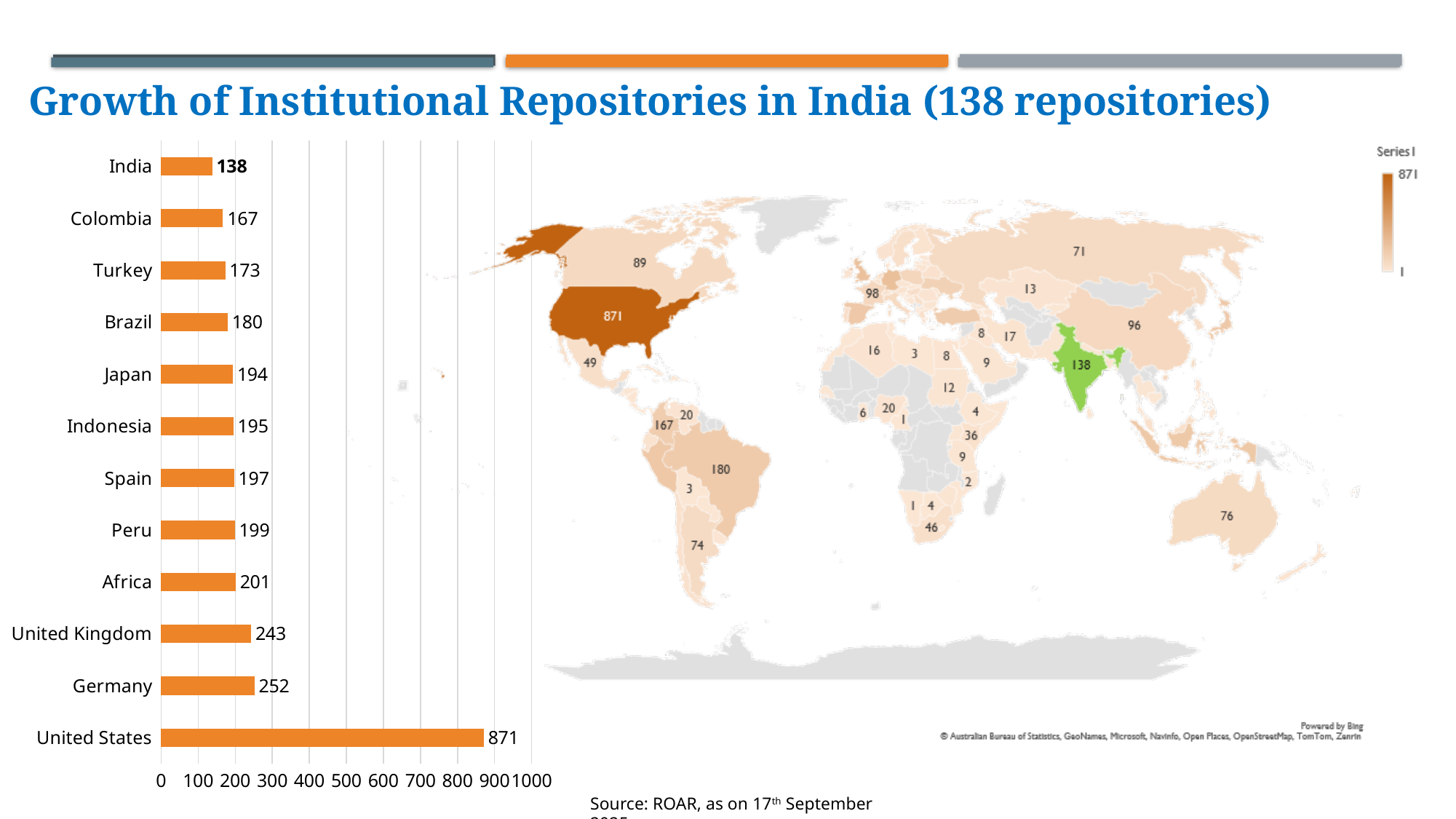
What kind of chart is shown on the left of the slide? Bar chart On the map chart on the right, what value is labelled on Australia? 76 On the bar chart on the left, which is larger, the value for United Kingdom or the value for Africa? United Kingdom On the map chart on the right, what value is labelled on the United States? 871 On the bar chart on the left, what is the difference between the values for United States and Germany? 619 On the bar chart on the left, how many categories are shown? 12 On the bar chart on the left, which category has the highest value? United States On the bar chart on the left, what is the value for India? 138 On the map chart on the right, what is the name of the series shown in the legend? Series 1 On the bar chart on the left, what is the value for Germany? 252 On the bar chart on the left, what is the difference between the values for Colombia and India? 29 On the bar chart on the left, which category has the lowest value? India